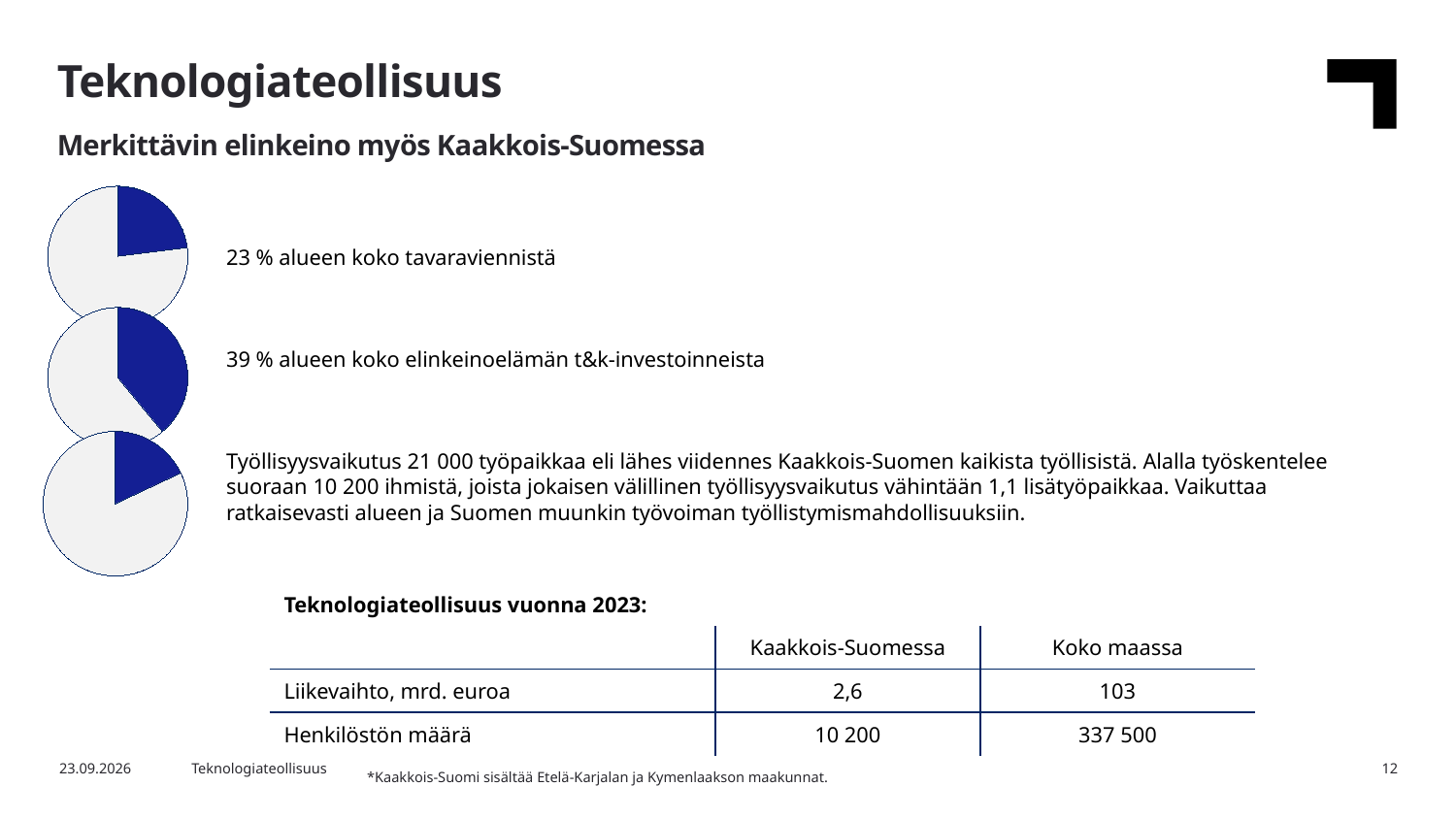
In the middle pie chart, what share does the highlighted (blue) slice represent? 39 % According to the middle pie chart, what share of the region's business R&D investments (t&k-investoinnit) does the technology industry account for? 39 % Is the highlighted slice in the top pie chart larger or smaller than half of the pie? Smaller In the top pie chart, what share does the highlighted (blue) slice represent? 23 % What colour is used for the highlighted slice in the pie charts? Blue Which of the three pie charts has the smallest highlighted slice? The bottom one According to the top pie chart, what share of the region's total goods exports (tavaravienti) does the technology industry account for? 23 % Which pie chart has the larger highlighted slice, the top one or the middle one? The middle one How many pie charts are on the slide? 3 What kind of charts are shown on the left side of the slide? Pie charts What is the difference in percentage points between the highlighted shares of the middle pie chart (39 %) and the top pie chart (23 %)? 16 percentage points Which of the three pie charts has the largest highlighted slice? The middle one (39 %)